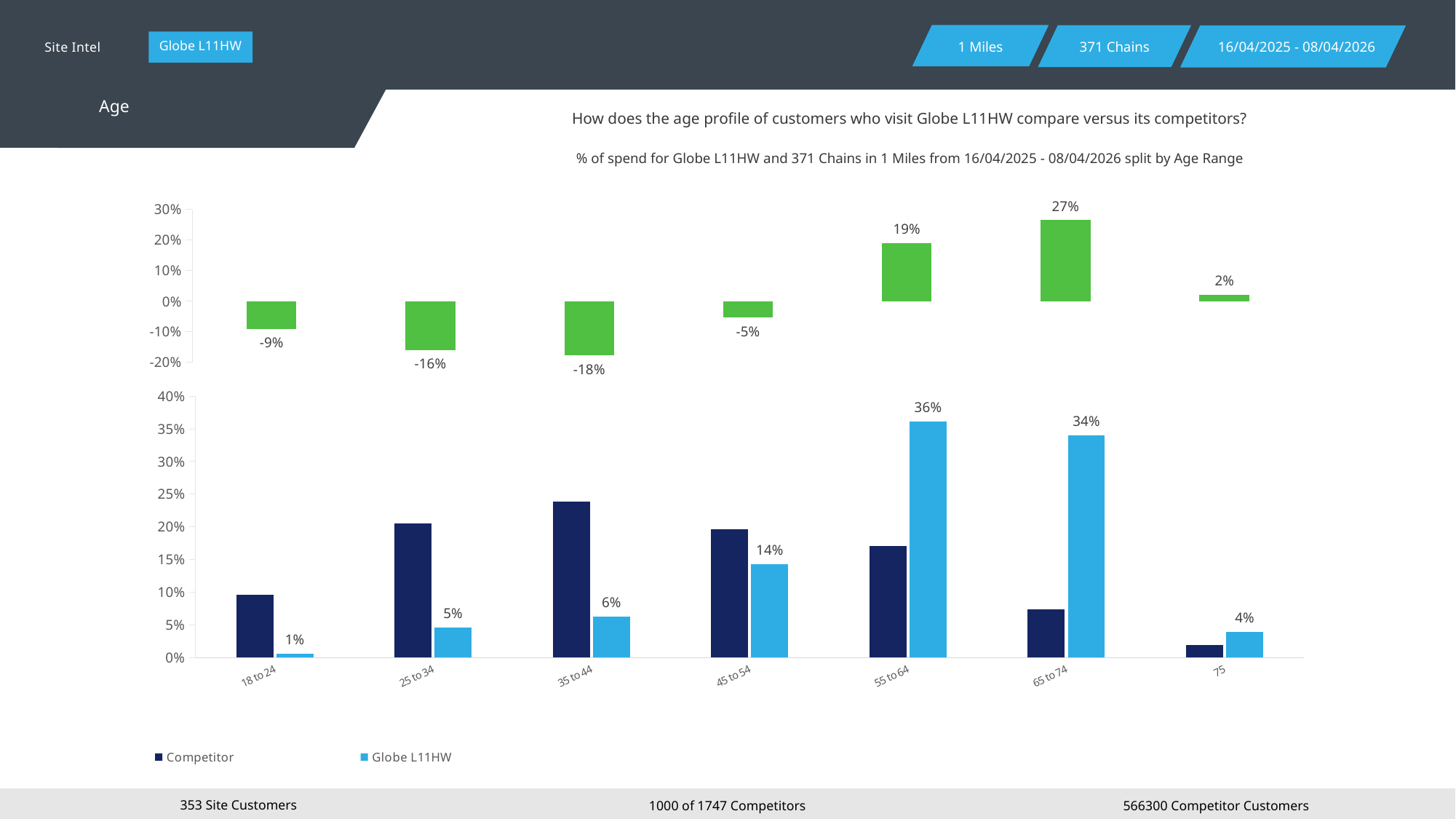
In the bottom chart, is the Competitor value for 35 to 44 greater or less than 20%? greater How many age range categories are shown in the bottom chart? 7 In the top chart, which age range has the highest value? 65 to 74 How many series does the legend of the bottom chart list? 2 In the bottom chart, what is the Globe L11HW value for the 55 to 64 age range? 36% In the bottom chart, which age range has the highest Globe L11HW value? 55 to 64 In the bottom chart, for the 45 to 54 age range, which is larger: Competitor or Globe L11HW? Competitor In the top chart, what is the value for the 65 to 74 age range? 27% In the bottom chart, which age range has the lowest Globe L11HW value? 18 to 24 In the bottom chart, is the Competitor value for 65 to 74 greater or less than 10%? less In the top chart, what is the difference between the values for 65 to 74 and 55 to 64? 8 percentage points In the top chart, which age range has the lowest value? 35 to 44